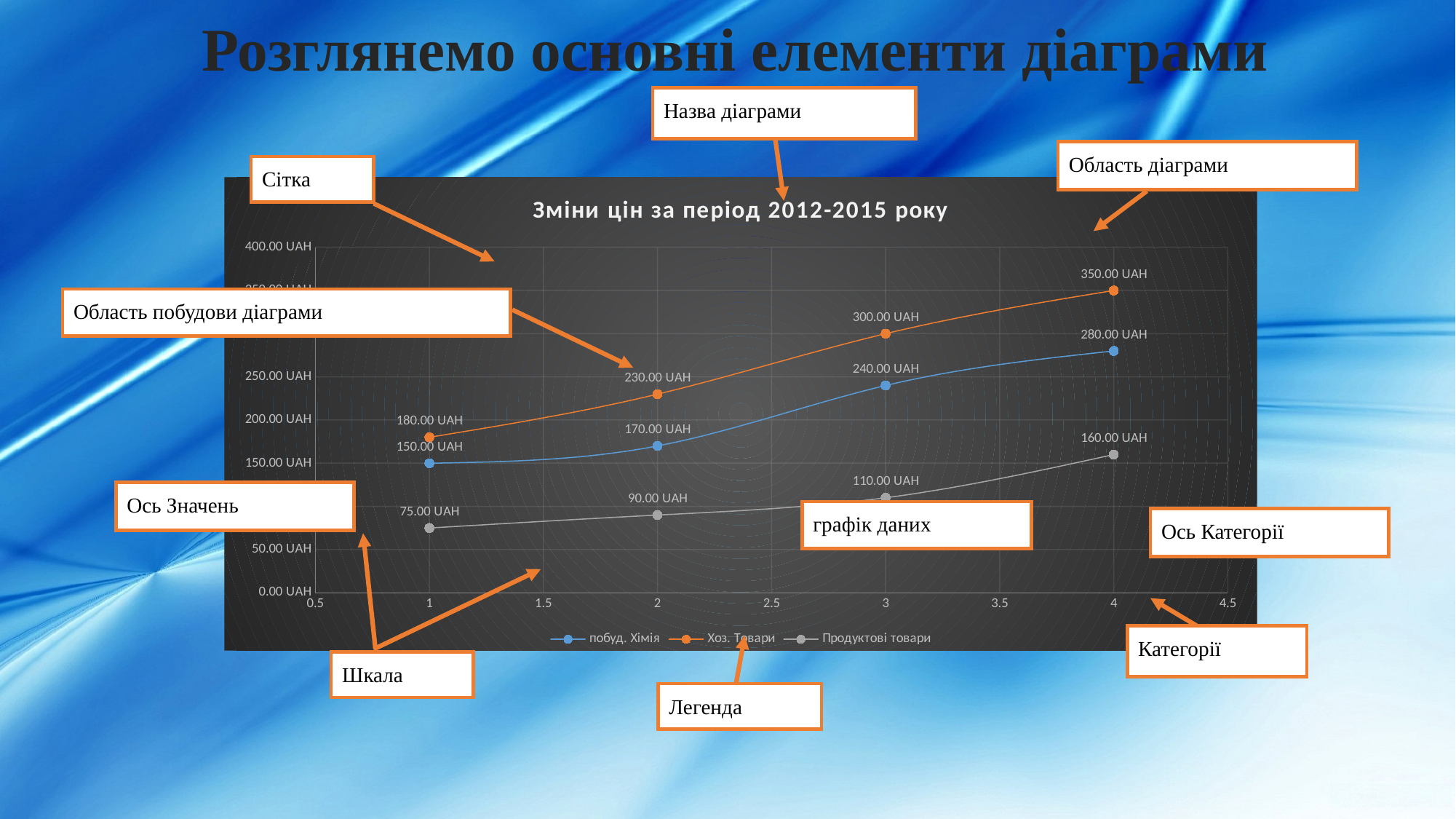
Which is larger: побуд. Хімія at category 3 or Хоз. Товари at category 1? побуд. Хімія at category 3 Which series has the lowest value at category 2? Продуктові товари What type of chart is shown on the slide? line chart Which series has the highest value at category 4? Хоз. Товари What is the value of Хоз. Товари at category 3? 300.00 UAH What is the title of the chart? Зміни цін за період 2012-2015 року What is the value of побуд. Хімія at category 1? 150.00 UAH Do the values of Продуктові товари rise or fall from category 1 to category 4? rise What is the value of Продуктові товари at category 4? 160.00 UAH What is the difference between Хоз. Товари and побуд. Хімія at category 2? 60.00 UAH How many series does the legend list? 3 How many data points does each series have? 4